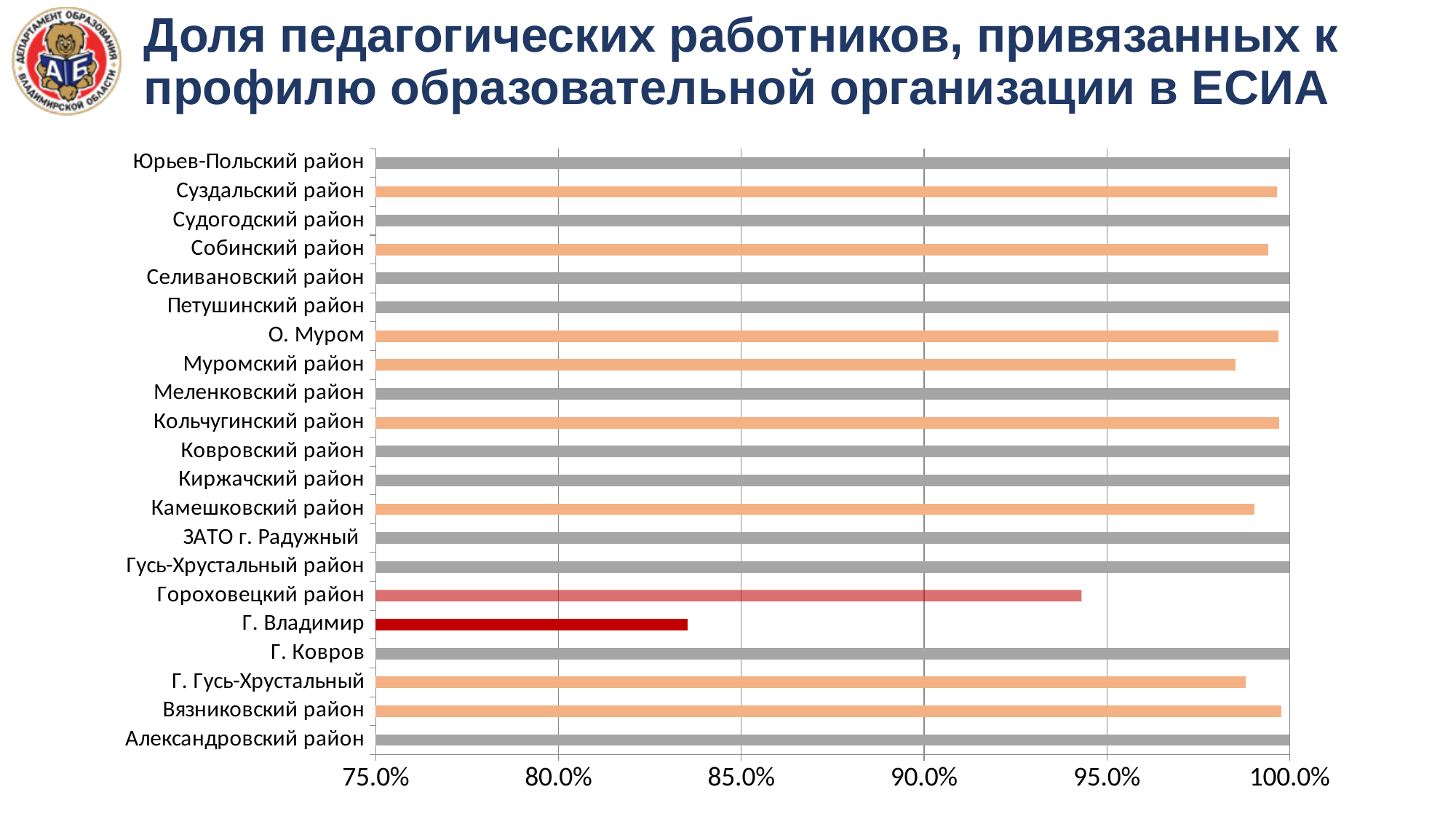
How many districts/categories are plotted on the chart? 21 Is the value for Г. Владимир greater or less than 85.0%? less Is the value for Гороховецкий район greater or less than 90.0%? greater Which is larger, the value for Муромский район or the value for Гороховецкий район? Муромский район Is the value for Гороховецкий район greater or less than 95.0%? less What colour is the bar for Г. Владимир? dark red What is the lowest value shown on the horizontal axis of the chart? 75.0% What kind of chart is shown on the slide? bar chart Which category has the lowest value on the chart? Г. Владимир What value does the bar for Г. Ковров reach on the axis? 100.0% Which is larger, the value for Гороховецкий район or the value for Г. Владимир? Гороховецкий район